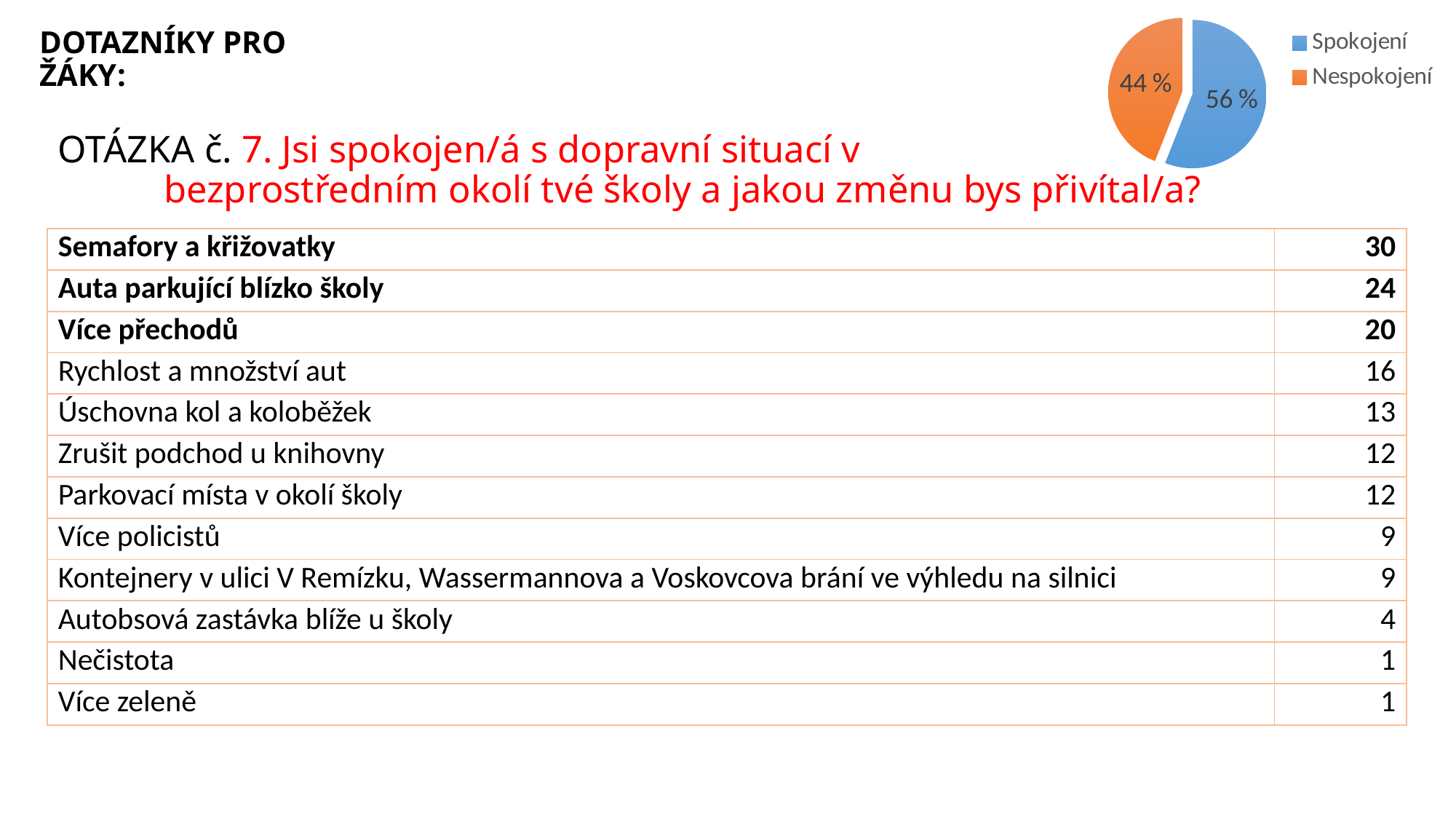
What colour is the Spokojení slice in the pie chart? blue What share of the pie does the Nespokojení slice represent? 44 % What colour is the Nespokojení slice in the pie chart? orange Which slice of the pie chart is the largest? Spokojení In the pie chart, which is larger: Spokojení or Nespokojení? Spokojení In the pie chart, what is the value for Nespokojení? 44 % What kind of chart is shown in the top right of the slide? pie chart In the pie chart, what is the difference between the Spokojení and Nespokojení shares? 12 % How many slices does the pie chart have? 2 In the pie chart, what is the value for Spokojení? 56 % Which slice of the pie chart is the smallest? Nespokojení How many entries does the pie chart's legend list? 2